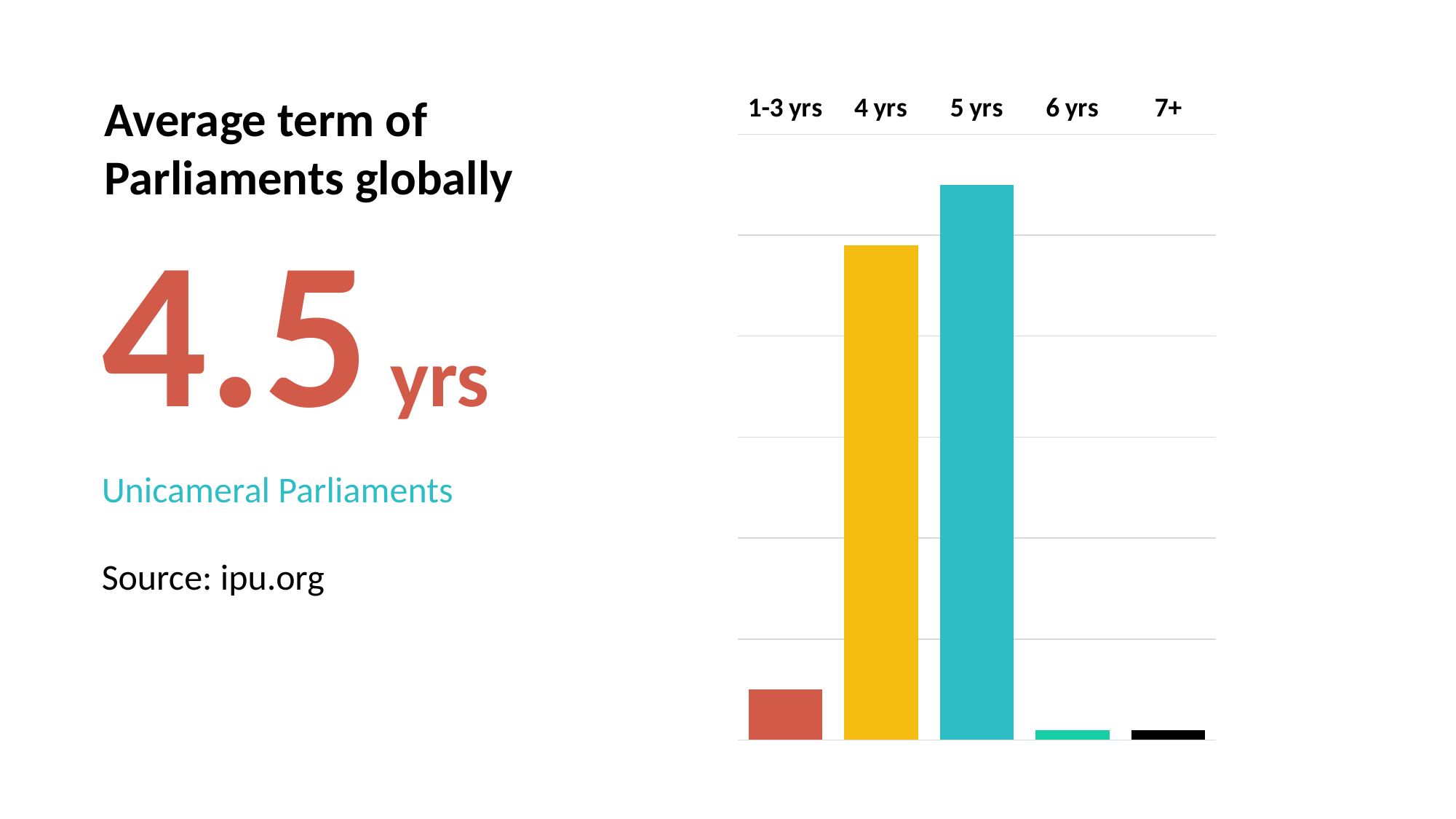
How many categories are shown on the x axis of the chart? 5 What kind of chart is shown on the slide? bar chart Which bar is taller, 1-3 yrs or 6 yrs? 1-3 yrs Which bar is taller, 1-3 yrs or 4 yrs? 4 yrs What is the title text shown to the left of the chart? Average term of Parliaments globally What colour is the bar for the 5 yrs category? teal Which bar is taller, 5 yrs or 7+? 5 yrs Which category has the tallest bar in the chart? 5 yrs Which category has the second tallest bar in the chart? 4 yrs